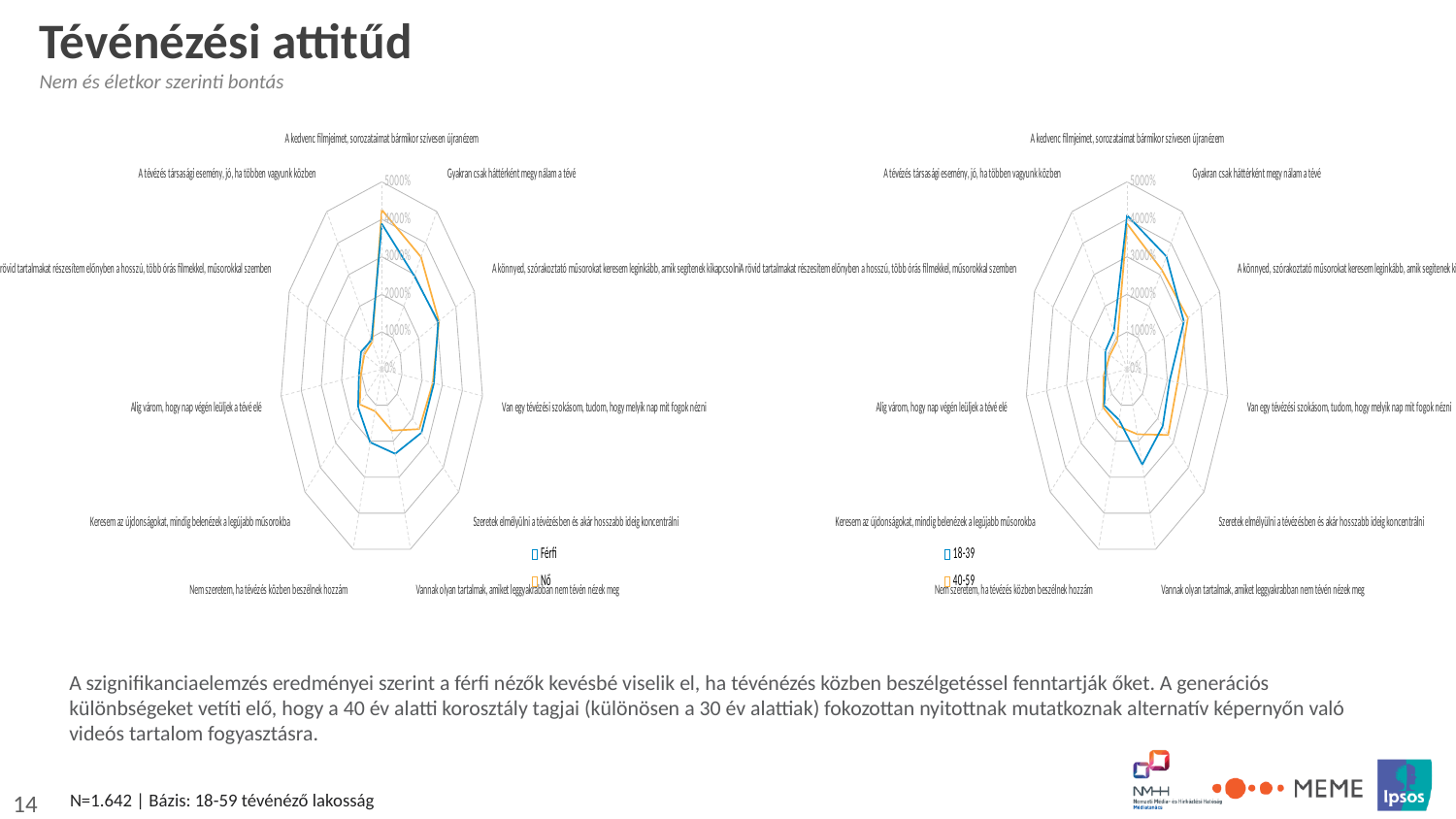
What kind of chart is the left chart on the slide? radar chart In the right chart, which series has the larger value for 'Vannak olyan tartalmak, amiket leggyakrabban nem tévén nézek meg': 18-39 or 40-59? 18-39 What are the two series named in the legend of the left chart? Férfi and Nő How many series does the legend of the right chart list? 2 What are the two series named in the legend of the right chart? 18-39 and 40-59 In the right chart, which statement has the highest value for the 18-39 series? A kedvenc filmjeimet, sorozataimat bármikor szívesen újranézem In the left chart, which series has the larger value for 'Nem szeretem, ha tévézés közben beszélnek hozzám': Férfi or Nő? Férfi How many series does the legend of the left chart list? 2 What kind of chart is the right chart on the slide? radar chart In the left chart, which statement has the highest value for the Férfi series? A kedvenc filmjeimet, sorozataimat bármikor szívesen újranézem How many statement categories (axes) does the left chart have? 11